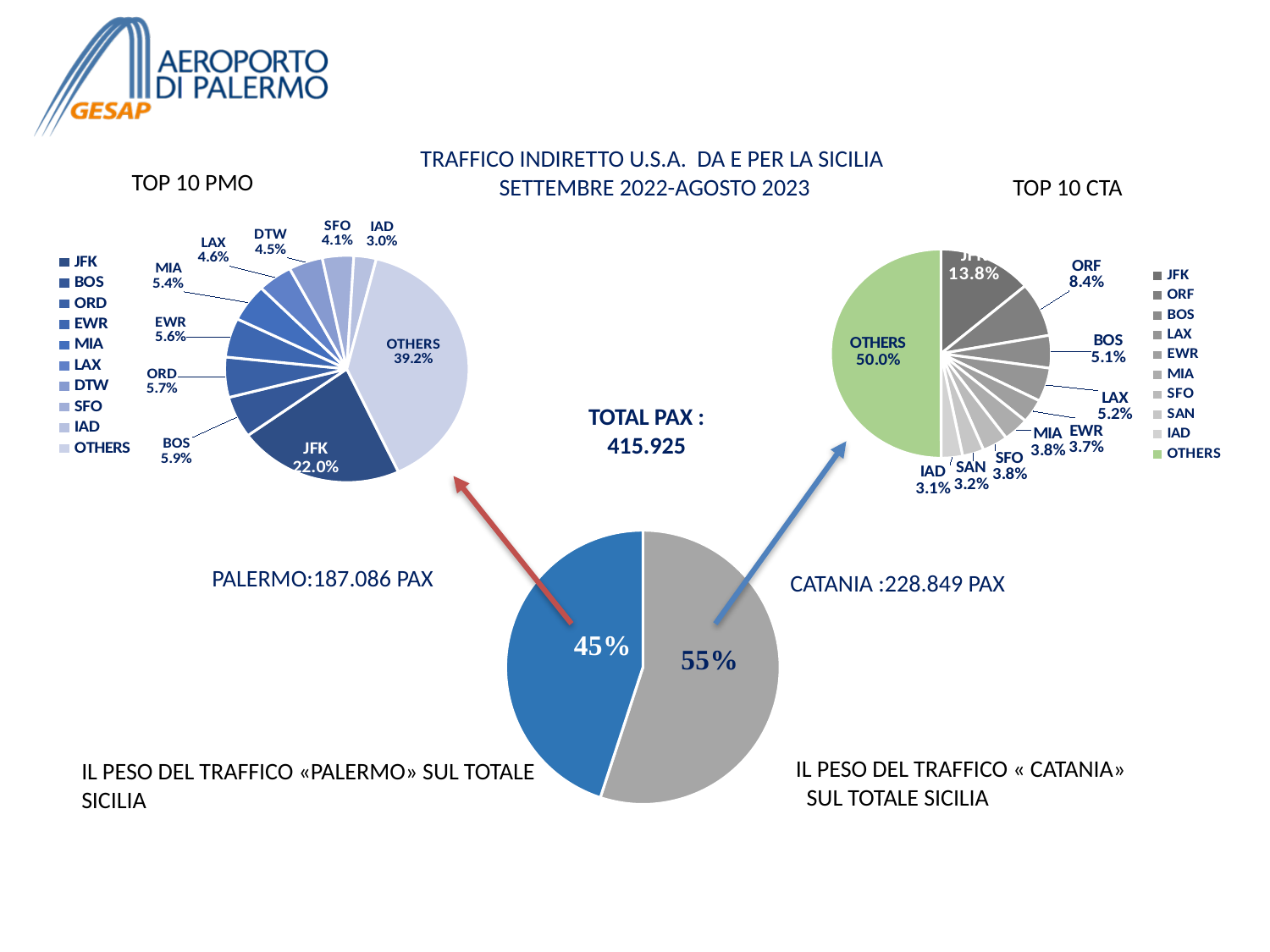
In the TOP 10 PMO pie chart, what share does OTHERS have? 39.2% In the TOP 10 PMO pie chart, what share does JFK have? 22.0% In the TOP 10 CTA pie chart, which slice has the smallest share? IAD In the TOP 10 CTA pie chart, what share does OTHERS have? 50.0% In the TOP 10 PMO pie chart, which slice has the smallest share? IAD How many entries does the legend of the TOP 10 CTA pie chart list? 10 In the TOP 10 CTA pie chart, which is larger, the share for ORF or the share for BOS? ORF In the TOP 10 CTA pie chart, what share does ORF have? 8.4% In the centre pie chart, what share of the total Sicilia traffic does Catania have? 55% In the TOP 10 PMO pie chart, what is the difference between the JFK share and the BOS share? 16.1% What kind of chart is used for the TOP 10 PMO data? Pie chart In the TOP 10 PMO pie chart, which named airport (excluding OTHERS) has the largest share? JFK